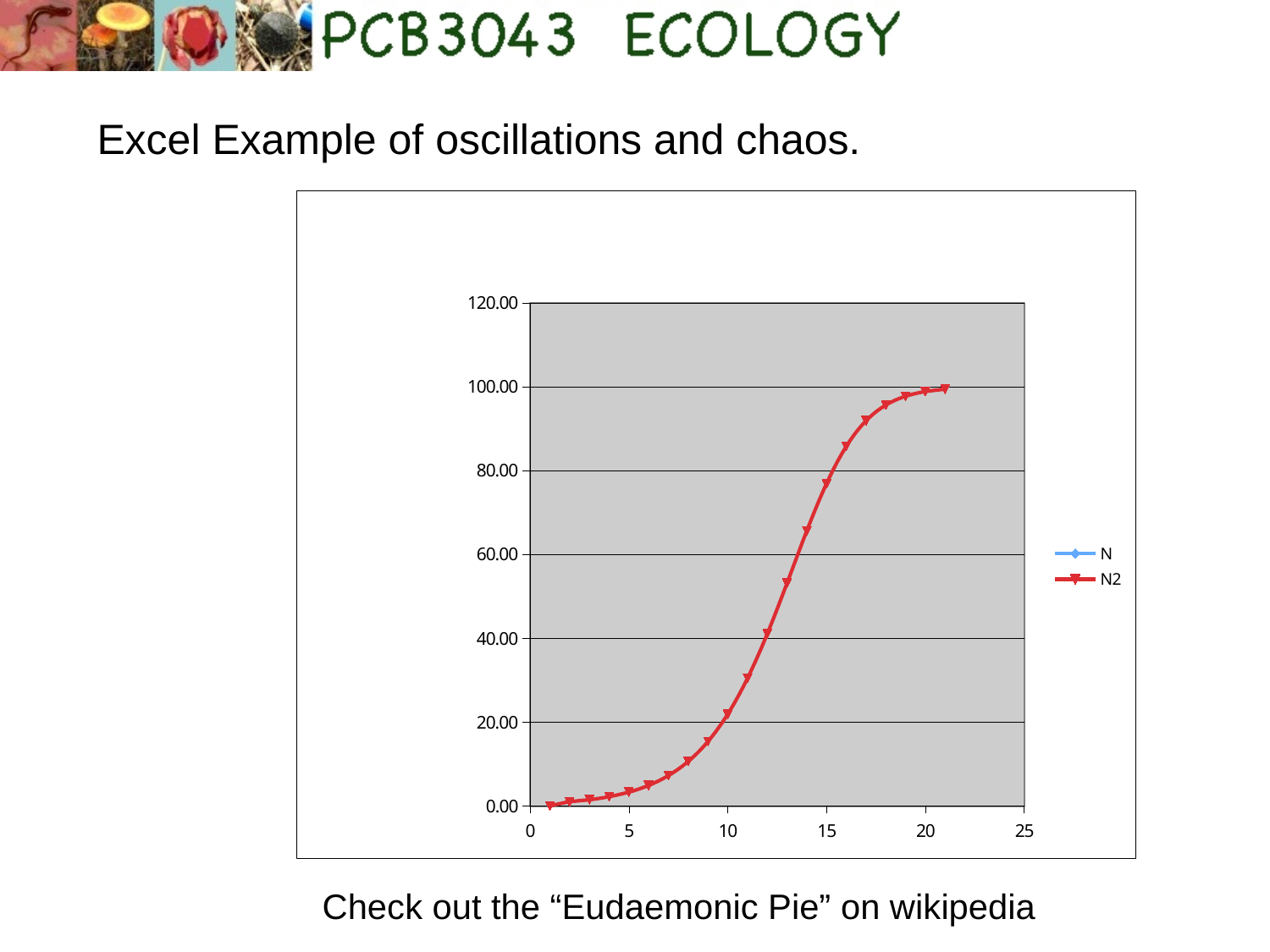
What colour is the N2 line? red Is the N2 value at x = 20 greater or less than 80.00? greater What are the names of the series listed in the legend? N and N2 Is the N2 value at x = 5 greater or less than 20.00? less Is the N2 value at x = 15 greater or less than 60.00? greater How many series does the legend list? 2 Which is larger, the N2 value at x = 10 or the N2 value at x = 15? x = 15 What is the highest tick value shown on the y axis? 120.00 What kind of chart is shown on the slide? line chart Do the N2 values rise or fall as x increases from 0 to 21? rise